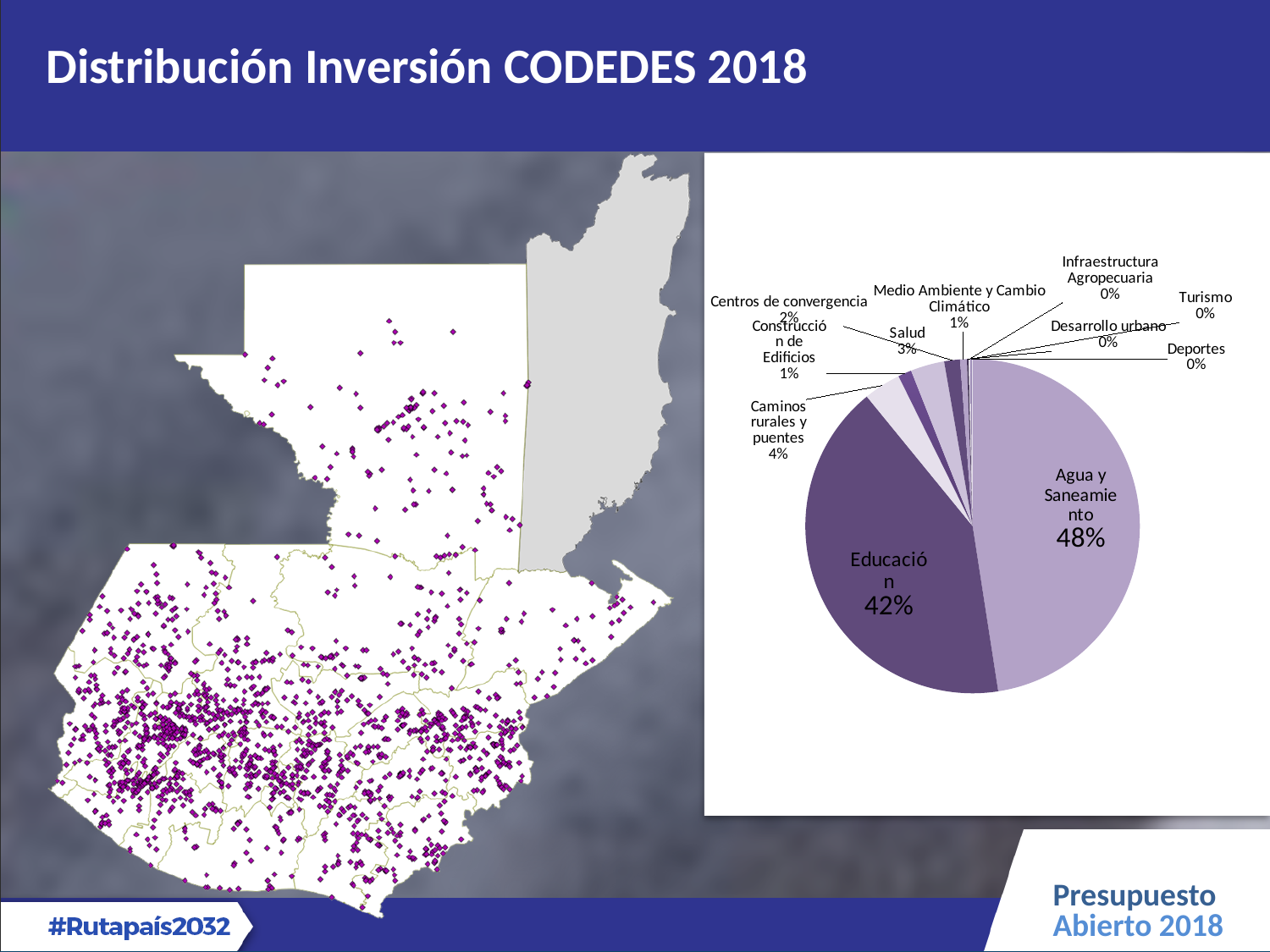
How many categories are labelled in the pie chart? 11 What percentage is shown for Caminos rurales y puentes? 4% Which category has the largest slice of the pie chart? Agua y Saneamiento What percentage is shown for Turismo in the pie chart? 0% What is the difference in percentage points between Agua y Saneamiento and Educación? 6 What share of the pie does Agua y Saneamiento represent? 48% What is the title of the slide containing the pie chart? Distribución Inversión CODEDES 2018 Which is larger in the pie chart, Salud or Caminos rurales y puentes? Caminos rurales y puentes What percentage is shown for Salud in the pie chart? 3% What kind of chart is shown on the right side of the slide? pie chart What percentage is shown for Centros de convergencia? 2% What is the value shown for Educación in the pie chart? 42%